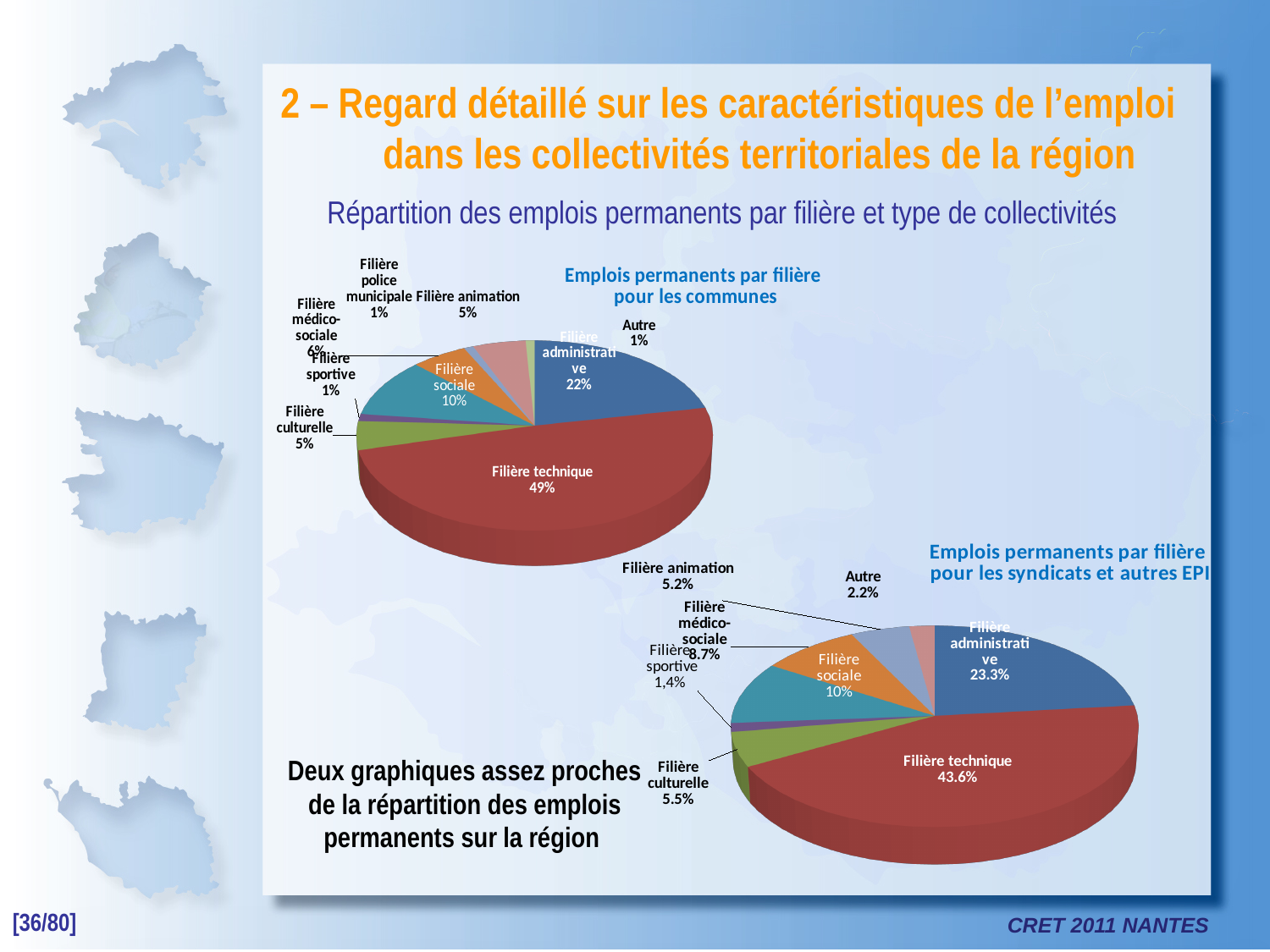
What type of chart is 'Emplois permanents par filière pour les communes'? Pie chart In the chart 'Emplois permanents par filière pour les communes', what is the difference between Filière technique and Filière administrative? 27% How many slices does the chart 'Emplois permanents par filière pour les syndicats et autres EPI' have? 8 In the chart 'Emplois permanents par filière pour les communes', what share is Filière administrative? 22% In the chart 'Emplois permanents par filière pour les communes', what share is Filière médico-sociale? 6% In the chart 'Emplois permanents par filière pour les communes', which filière has the largest share? Filière technique In the chart 'Emplois permanents par filière pour les syndicats et autres EPI', what share is Filière technique? 43.6% In the chart 'Emplois permanents par filière pour les communes', what share is Filière technique? 49% In the chart 'Emplois permanents par filière pour les syndicats et autres EPI', what share is Filière administrative? 23.3% In the chart 'Emplois permanents par filière pour les syndicats et autres EPI', what share is Filière médico-sociale? 8.7% In the chart 'Emplois permanents par filière pour les syndicats et autres EPI', what is the difference between Filière technique and Filière sociale? 33.6% In the chart 'Emplois permanents par filière pour les syndicats et autres EPI', which is larger, Filière culturelle or Filière animation? Filière culturelle